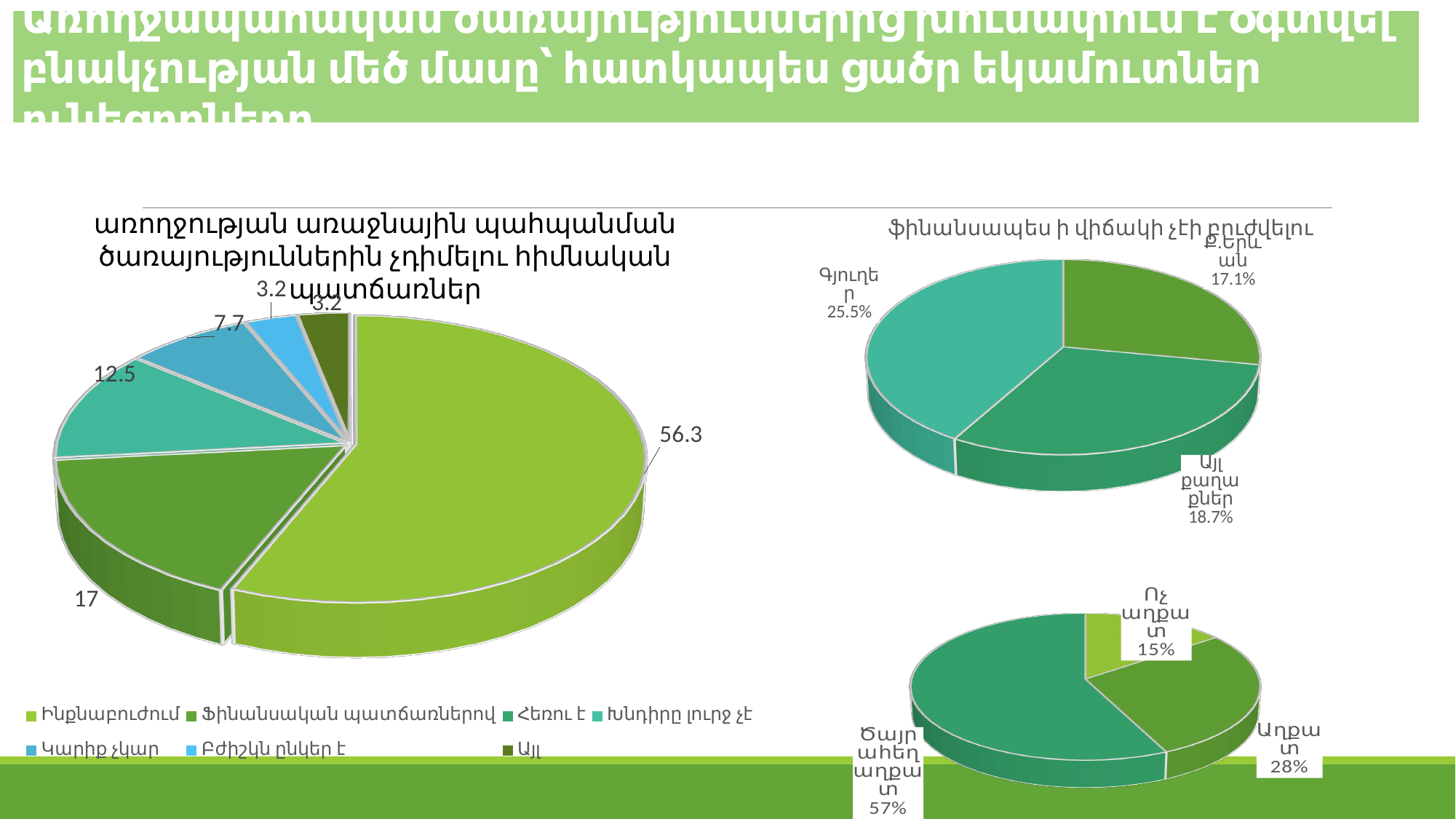
In the left pie chart, which legend category has the largest slice? Ինքնաբուժում In the top-right pie chart, what value is shown for Ք.Երևան? 17.1% In the left pie chart, what value is shown for the largest slice? 56.3 In the top-right pie chart, which is larger, Այլ քաղաքներ or Ք.Երևան? Այլ քաղաքներ How many entries does the legend of the left pie chart list? 7 What kind of chart is the left chart? Pie chart In the left pie chart, what is the difference between the 56.3 slice and the 17 slice? 39.3 In the left pie chart, what value is shown for the slice labelled Ֆինանսական պատճառներով? 17 In the bottom-right pie chart, what is the difference between Աղքատ and Ոչ աղքատ? 13% In the bottom-right pie chart, what value is shown for Ծայրահեղ աղքատ? 57% In the top-right pie chart, what value is shown for Գյուղեր? 25.5%